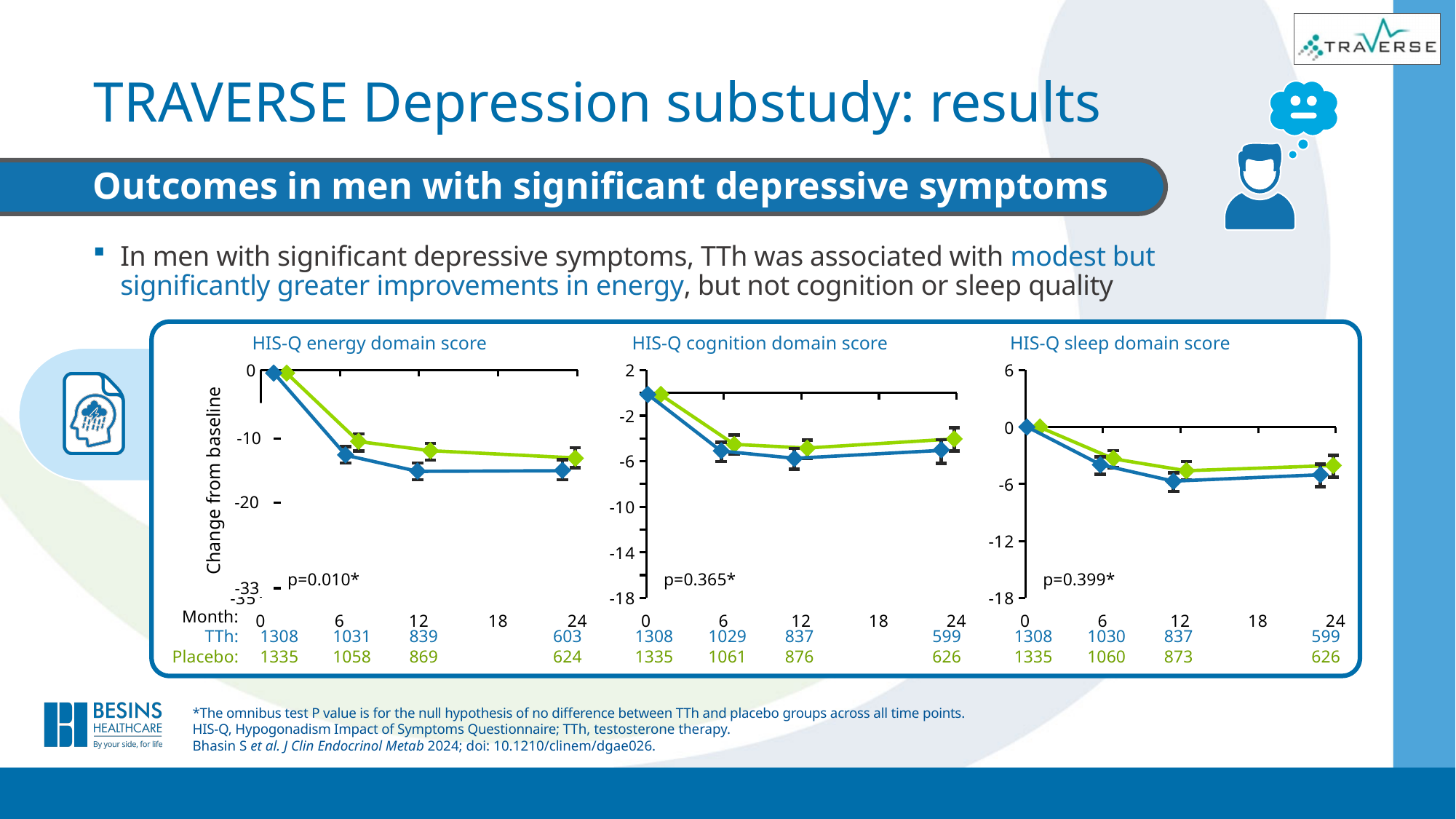
In the HIS-Q sleep domain score chart, how many TTh participants are listed at month 6? 1030 How many time points are plotted for each series in the HIS-Q cognition domain score chart? 4 In the HIS-Q energy domain score chart, how many TTh participants are listed at month 24? 603 How many series are plotted in the HIS-Q sleep domain score chart? 2 In the HIS-Q cognition domain score chart, how many placebo participants are listed at month 12? 876 In the HIS-Q sleep domain score chart, is the placebo value at month 24 greater or less than -6? greater In the HIS-Q energy domain score chart, do the TTh values rise or fall from month 0 to month 24? fall In the HIS-Q energy domain score chart, what is the p-value shown? p=0.010* In the HIS-Q sleep domain score chart, what is the p-value shown? p=0.399* In the HIS-Q energy domain score chart, is the TTh value at month 12 greater or less than -10? less In the HIS-Q cognition domain score chart, what is the p-value shown? p=0.365* What kind of chart is the HIS-Q energy domain score chart? line chart